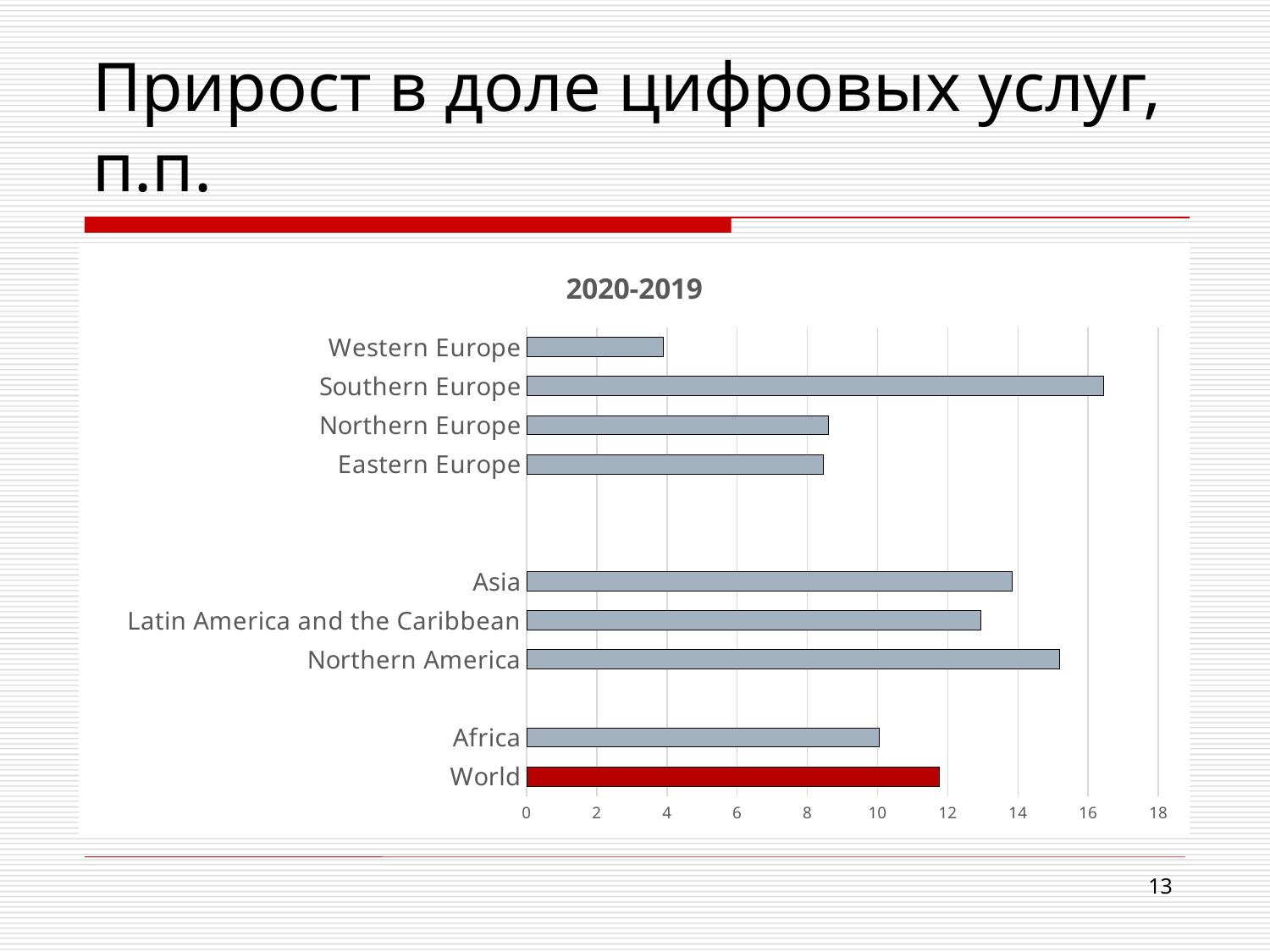
What kind of chart is shown on the slide? bar chart What is the title of the chart? 2020-2019 Which region has the lowest value in the chart? Western Europe Which has the larger value, Northern America or Asia? Northern America Which has the larger value, Africa or Latin America and the Caribbean? Latin America and the Caribbean Is the value for Southern Europe greater or less than 16? greater Which region has the highest value in the chart? Southern Europe Which bar in the chart is coloured red rather than grey? World How many categories (bars) are plotted in the chart? 9 Is the value for Northern America greater or less than 14? greater Is the value for World greater or less than 12? less